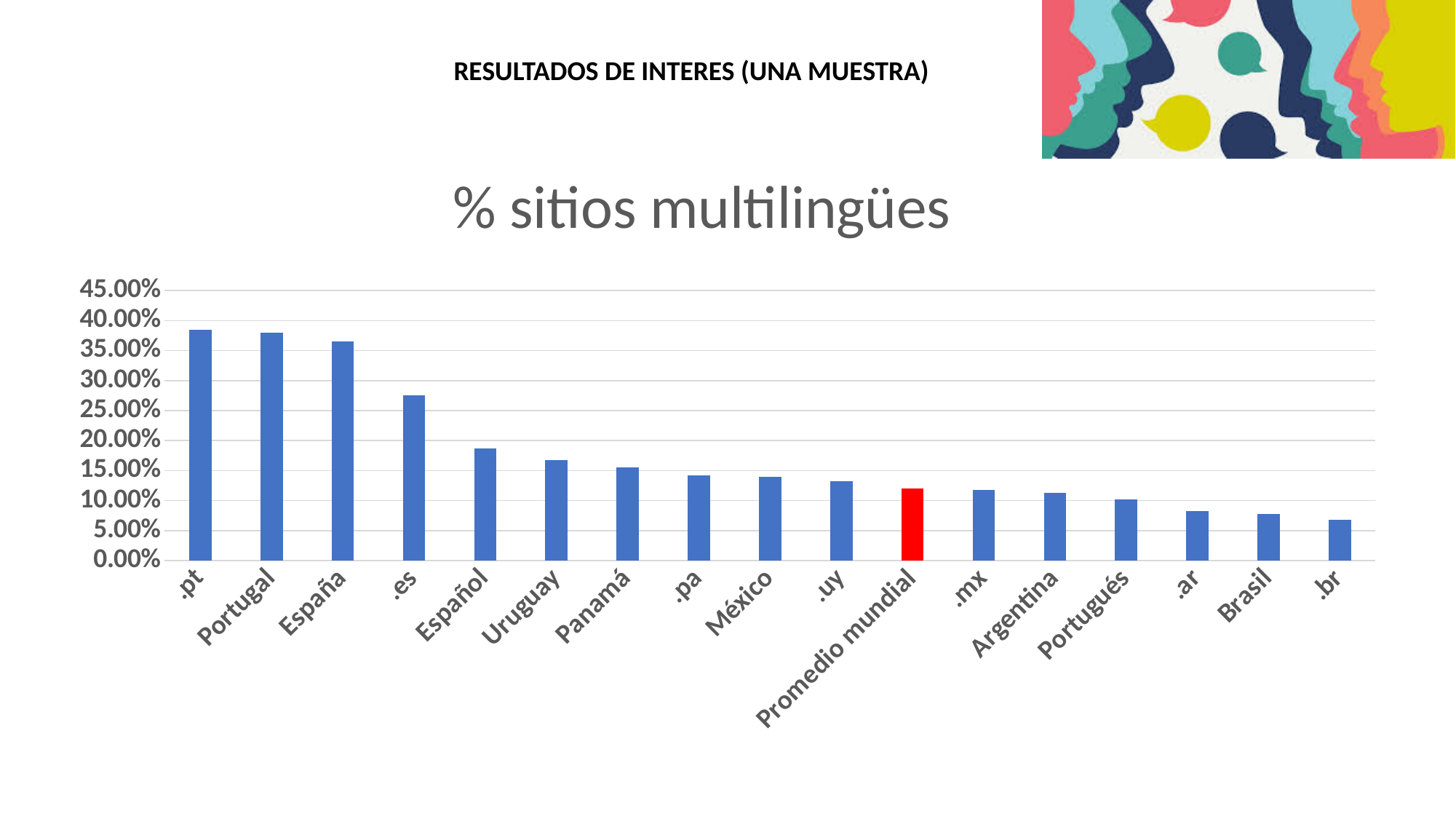
Which has a larger value, Uruguay or Brasil? Uruguay Is the value for España greater or less than 35.00%? greater Which category has the lowest value in the chart? .br Is the value for .es greater or less than 25.00%? greater How many categories are plotted on the x axis of the chart? 17 Which category is shown with a red bar? Promedio mundial Is the value for .br greater or less than 10.00%? less What is the title of the chart? % sitios multilingües Which has a larger value, .pt or .es? .pt What kind of chart is shown on the slide? bar chart Do the values rise or fall from left to right along the x axis? fall